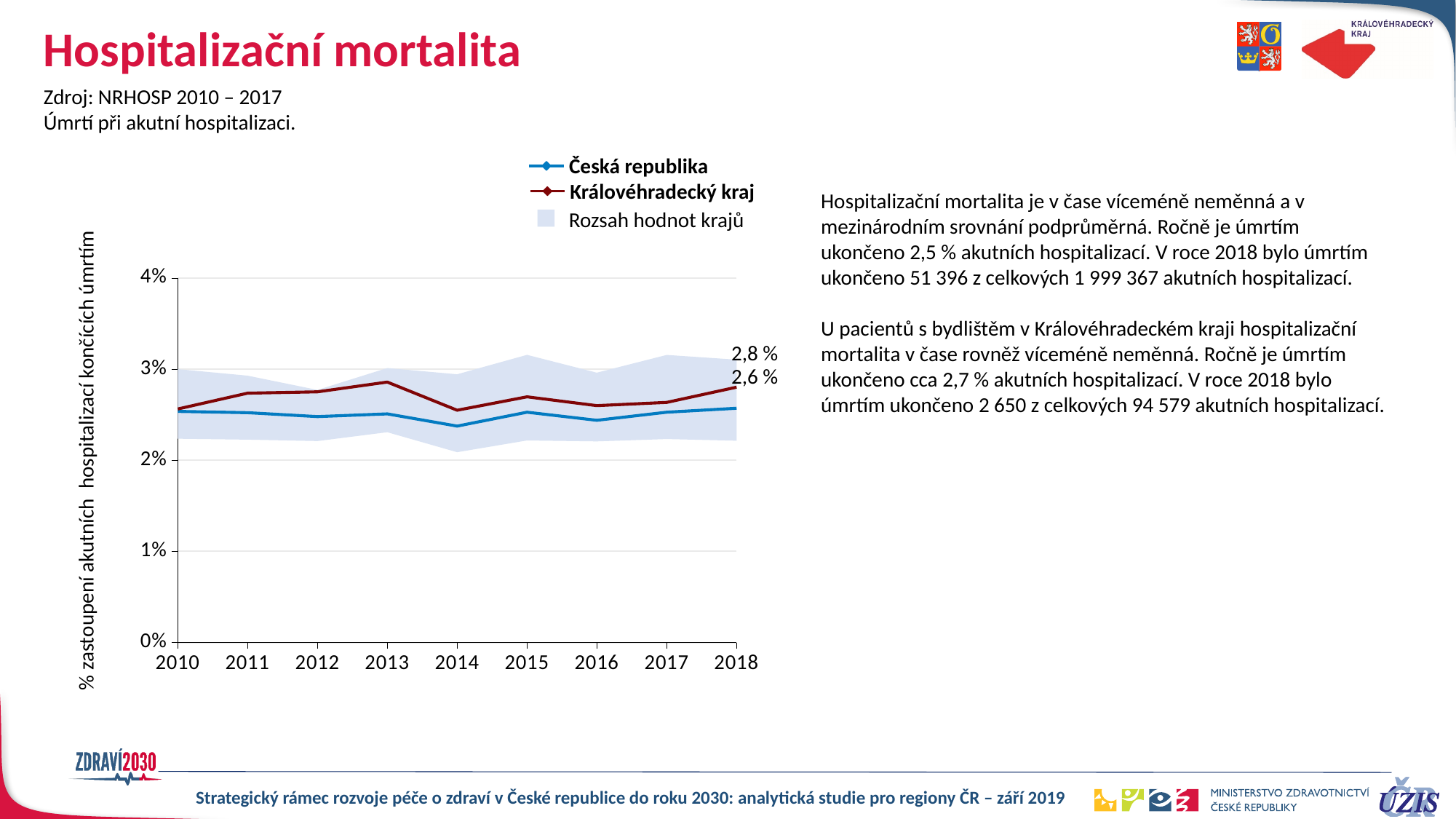
What is the difference between the 2018 values for Královéhradecký kraj and Česká republika? 0,2 % Is the value for Královéhradecký kraj in 2013 greater or less than 3%? less Is the value for Česká republika in 2014 greater or less than 2%? greater How many entries does the chart legend list? 3 What is the value for Česká republika in 2018? 2,6 % How many years are shown on the x axis of the chart? 9 Which legend entry is shown as a shaded area rather than a line? Rozsah hodnot krajů Does the value for Královéhradecký kraj rise or fall from 2013 to 2014? fall In 2018, which series has the higher value: Česká republika or Královéhradecký kraj? Královéhradecký kraj What colour is the line for Česká republika? blue What kind of chart is shown on the slide? line chart What is the value for Královéhradecký kraj in 2018? 2,8 %